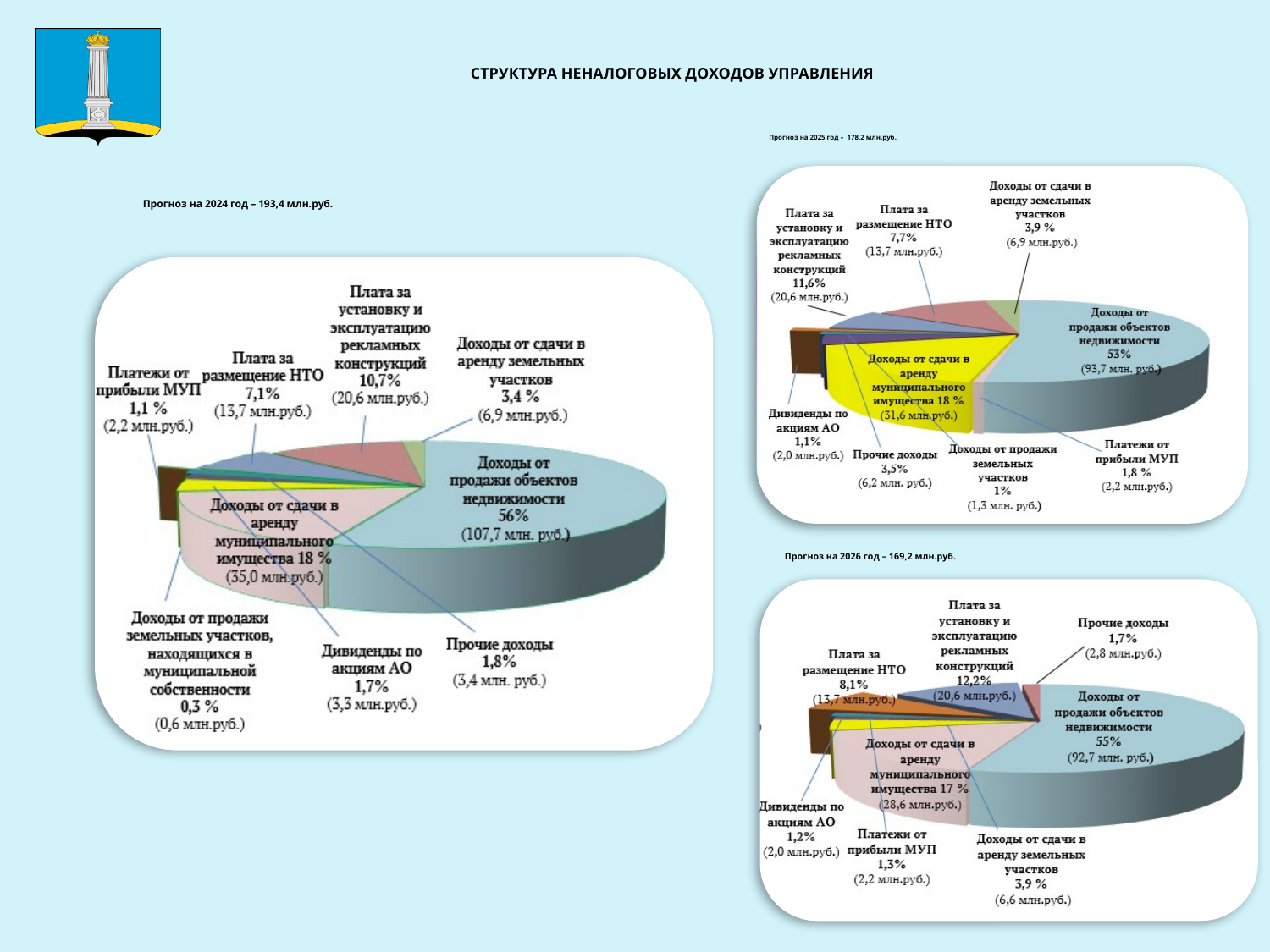
In the 2025 forecast chart, what is the difference in млн.руб. between 'Плата за размещение НТО' and 'Доходы от сдачи в аренду земельных участков'? 6,8 млн.руб. What total forecast amount is stated for 2026 above the bottom-right chart? 169,2 млн.руб. In the 2024 forecast chart, what share do 'Доходы от продажи объектов недвижимости' have? 56% In the 2024 forecast chart, which category has the smallest share? Доходы от продажи земельных участков, находящихся в муниципальной собственности In the 2025 forecast chart, what share do 'Плата за установку и эксплуатацию рекламных конструкций' have? 11,6% In the 2024 forecast chart, what is the value in млн.руб. for 'Доходы от сдачи в аренду муниципального имущества'? 35,0 млн.руб. In the 2025 forecast chart, which is larger: 'Прочие доходы' or 'Платежи от прибыли МУП'? Прочие доходы What kind of chart is used for the 2024 forecast (Прогноз на 2024 год)? Pie chart In the 2026 forecast chart (Прогноз на 2026 год), what share do 'Доходы от сдачи в аренду муниципального имущества' have? 17 % How many categories are shown in the 2024 forecast pie chart? 9 In the 2026 forecast chart, which category has the largest share? Доходы от продажи объектов недвижимости In the 2025 forecast chart (Прогноз на 2025 год), what is the value for 'Доходы от продажи объектов недвижимости'? 93,7 млн. руб.